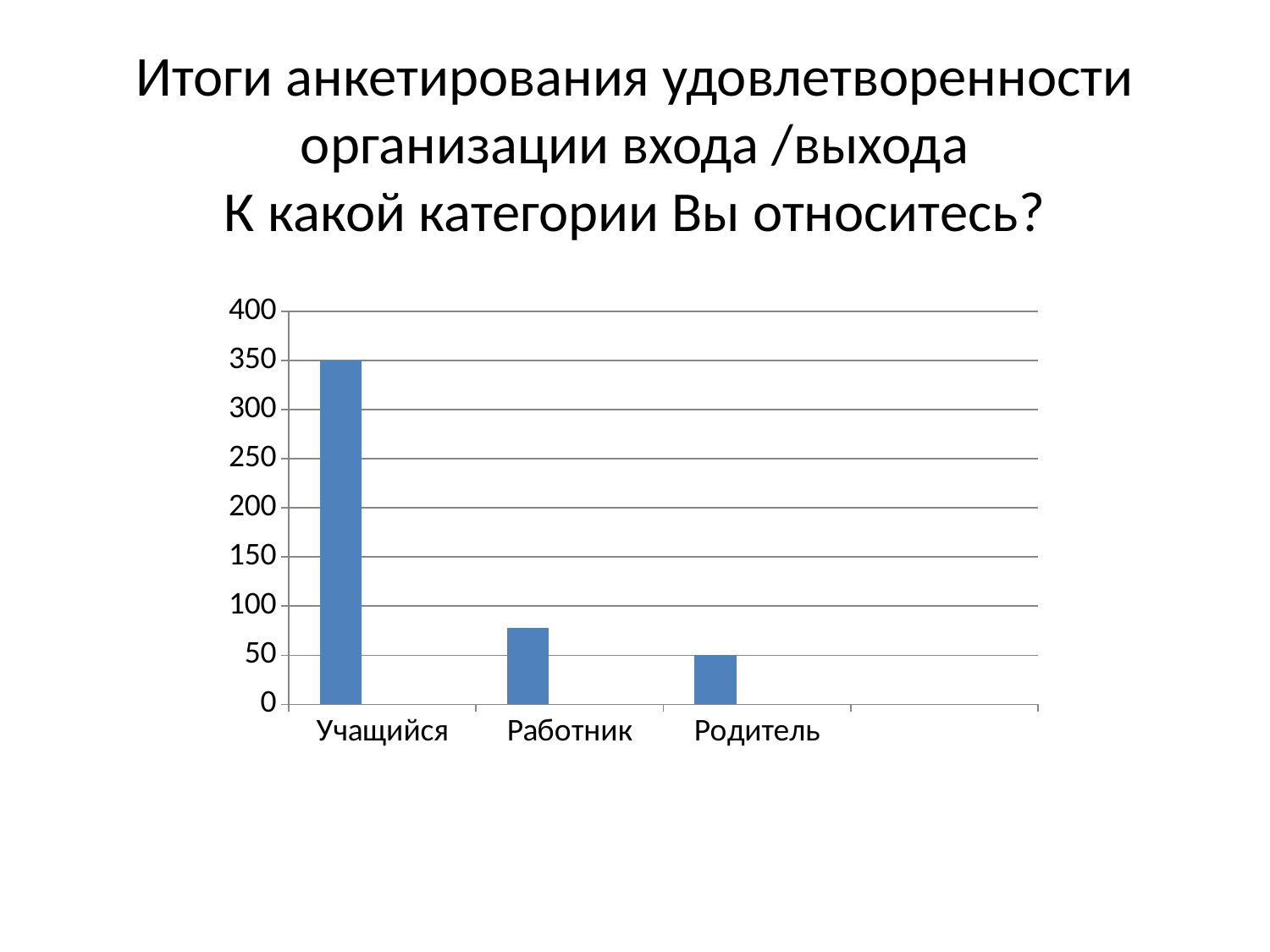
Is the value for Работник greater or less than 100? less What type of chart is shown on the slide? bar chart Which is larger, the value for Работник or the value for Родитель? Работник Which category has the lowest value? Родитель How many labelled categories are shown on the x axis? 3 What is the difference between the values for Учащийся and Родитель? 300 What is the value for Родитель? 50 What is the value for Учащийся? 350 Is the value for Работник greater or less than 50? greater What question does the slide title say the chart answers? К какой категории Вы относитесь? Which category has the highest value? Учащийся Do the values rise or fall from left to right along the x axis? fall